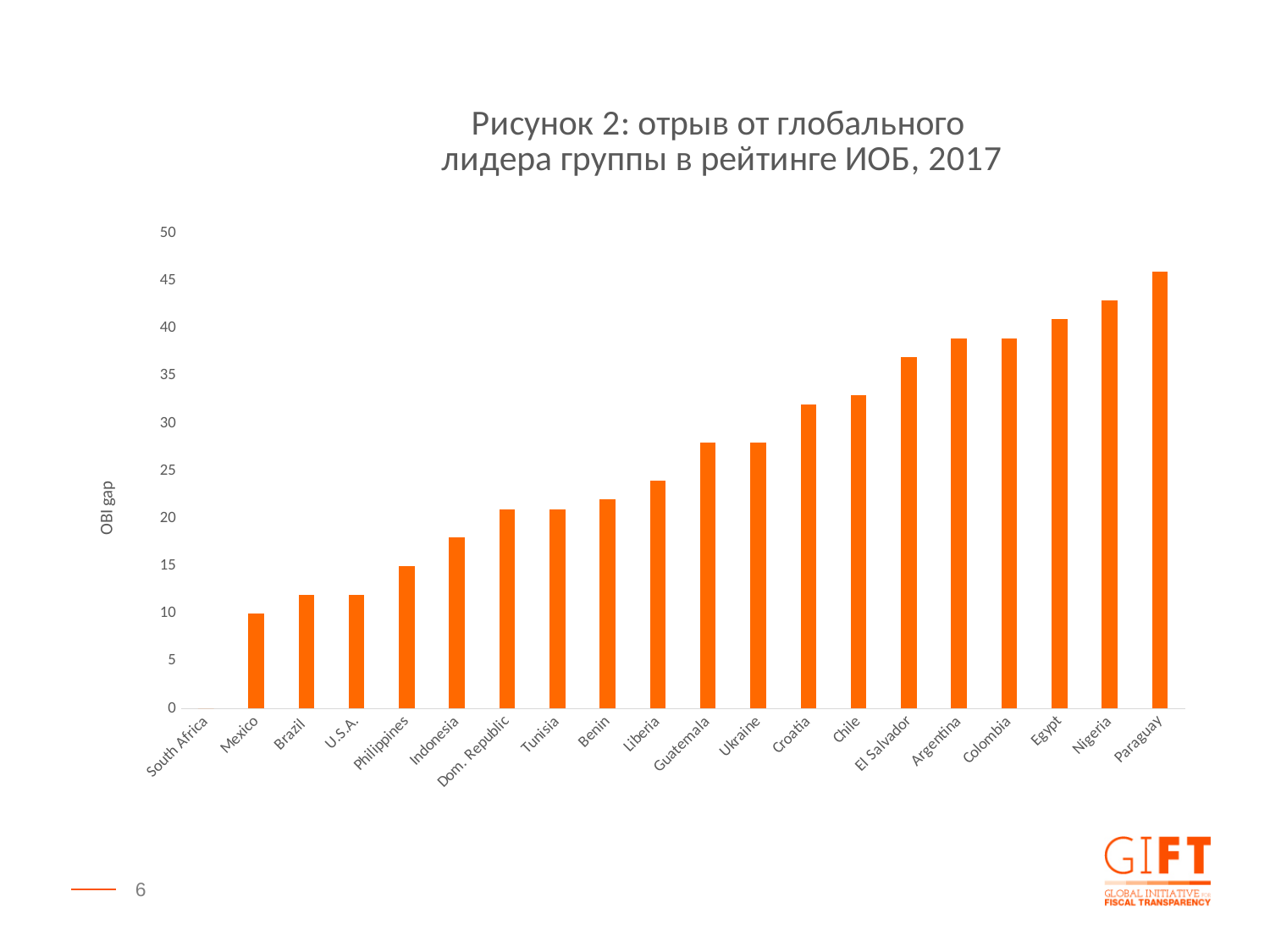
Which has a larger OBI gap, Egypt or Brazil? Egypt Which country has the lowest OBI gap in the chart? South Africa Which country has the highest OBI gap in the chart? Paraguay Is the value for Nigeria greater or less than 45? less Do the values rise or fall moving from left to right along the x axis? rise What is the label on the vertical axis of the chart? OBI gap Is the value for Liberia greater or less than 25? less Is the value for Paraguay greater or less than 45? greater What kind of chart is shown on the slide? bar chart How many countries are shown on the x axis of the chart? 20